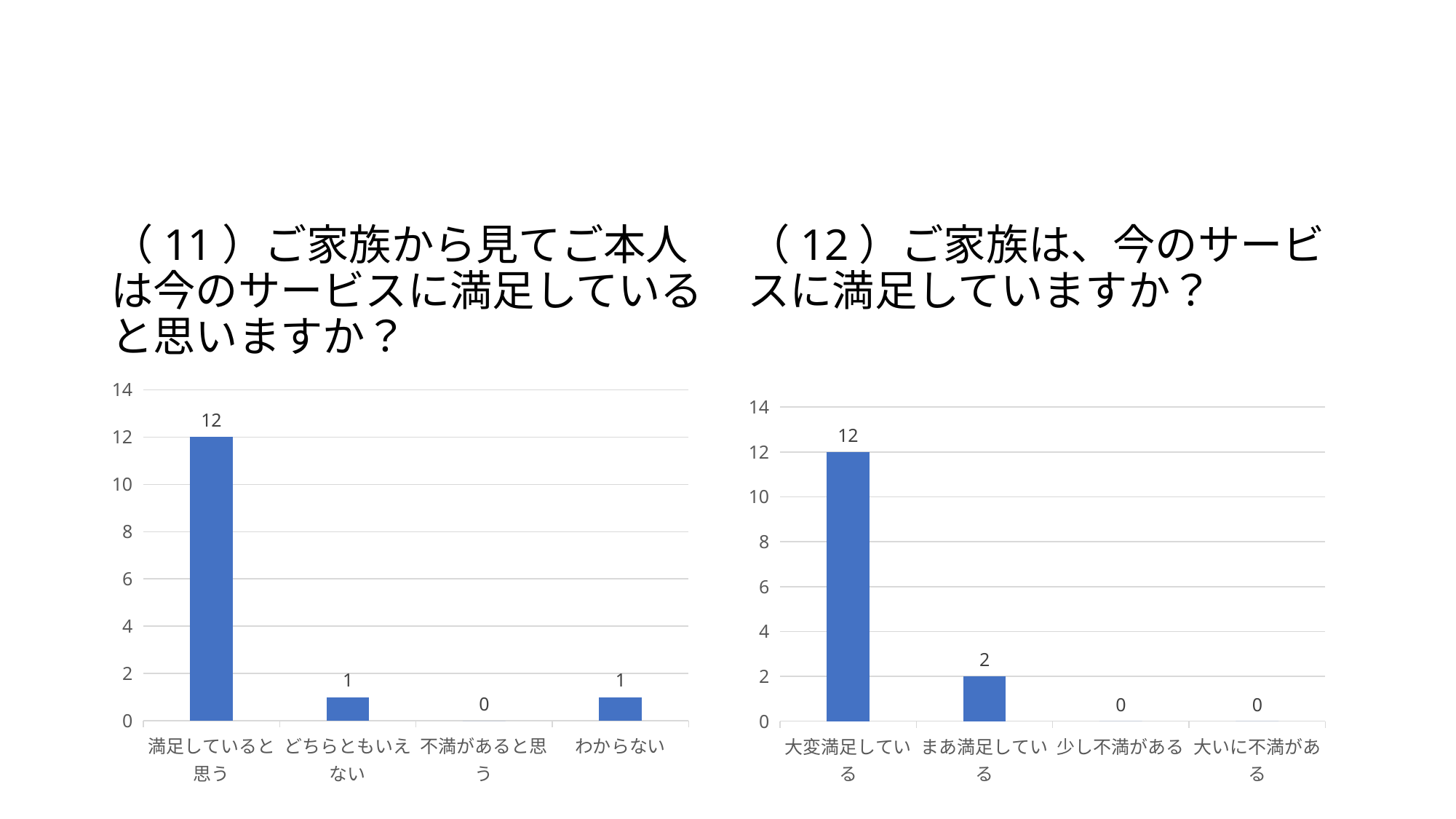
In the right chart (12), what is the value for まあ満足している? 2 In the left chart (11), which category has the highest value? 満足していると思う In the right chart (12), which category has the highest value? 大変満足している In the right chart (12), which is larger, まあ満足している or 少し不満がある? まあ満足している In the right chart (12), what is the value for 大変満足している? 12 In the right chart (12), what is the difference between 大変満足している and まあ満足している? 10 What kind of chart is the right chart (12)? Bar chart In the left chart (11), what is the value for 不満があると思う? 0 In the left chart (11), how many categories are shown on the x axis? 4 In the left chart (11), what is the value for 満足していると思う? 12 In the left chart (11), what is the difference between 満足していると思う and わからない? 11 In the left chart (11), is the value for 満足していると思う greater or less than 10? greater